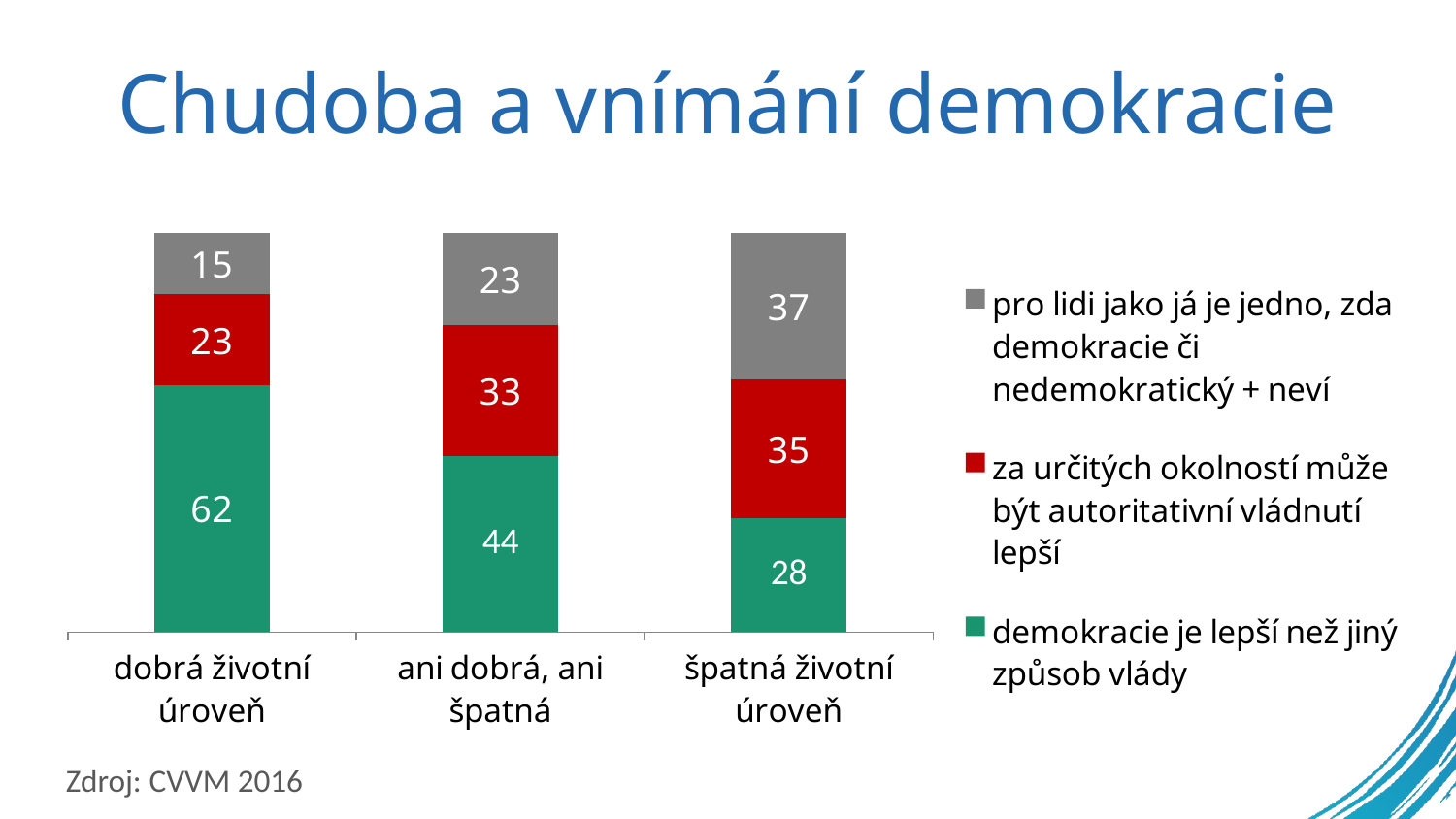
What is the total of the stacked bar for "ani dobrá, ani špatná"? 100 Which category has the lowest value for "pro lidi jako já je jedno, zda demokracie či nedemokratický + neví"? dobrá životní úroveň What is the value for "pro lidi jako já je jedno, zda demokracie či nedemokratický + neví" in the "špatná životní úroveň" category? 37 What kind of chart is shown on the slide? stacked bar chart How many categories are shown on the x axis? 3 Which category has the highest value for "demokracie je lepší než jiný způsob vlády"? dobrá životní úroveň Which is larger: the "za určitých okolností může být autoritativní vládnutí lepší" value for "ani dobrá, ani špatná" or for "špatná životní úroveň"? špatná životní úroveň How many series does the legend list? 3 What is the difference between the "demokracie je lepší než jiný způsob vlády" values for "dobrá životní úroveň" and "špatná životní úroveň"? 34 What is the value for "za určitých okolností může být autoritativní vládnutí lepší" in the "ani dobrá, ani špatná" category? 33 Does the value for "demokracie je lepší než jiný způsob vlády" rise or fall from "dobrá životní úroveň" to "špatná životní úroveň"? fall What is the value for "demokracie je lepší než jiný způsob vlády" in the "dobrá životní úroveň" category? 62